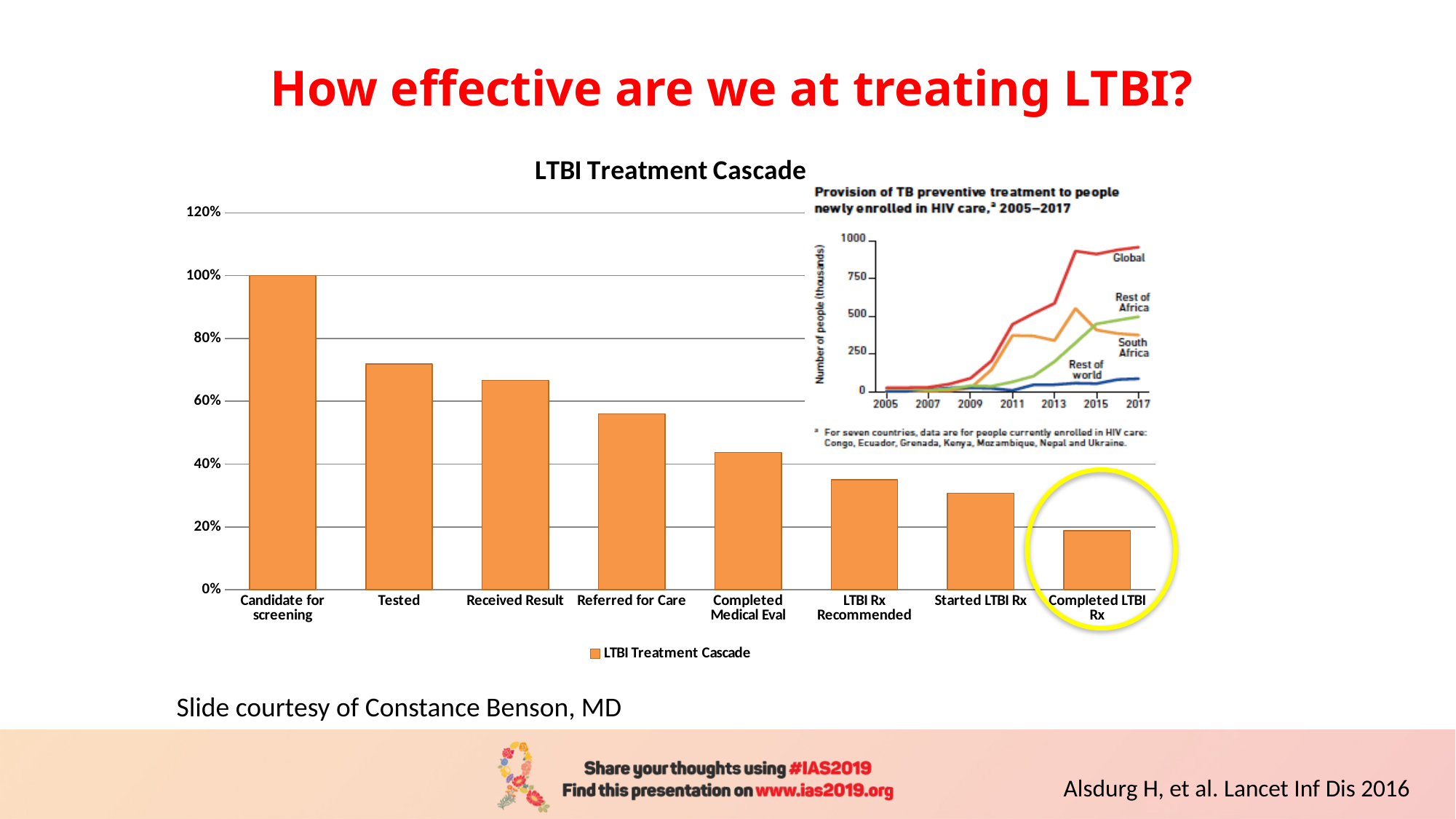
In the LTBI Treatment Cascade bar chart, what is the value for Candidate for screening? 100% In the LTBI Treatment Cascade bar chart, which is larger: Referred for Care or LTBI Rx Recommended? Referred for Care How many categories are shown in the LTBI Treatment Cascade bar chart? 8 In the LTBI Treatment Cascade bar chart, is the value for Completed Medical Eval greater or less than 40%? greater In the LTBI Treatment Cascade bar chart, do the values rise or fall from left to right along the x axis? Fall In the LTBI Treatment Cascade bar chart, which category has the lowest value? Completed LTBI Rx In the LTBI Treatment Cascade bar chart, is the value for Tested greater or less than 60%? greater In the LTBI Treatment Cascade bar chart, which category has the highest value? Candidate for screening What kind of chart is the LTBI Treatment Cascade chart? Bar chart How many series does the legend of the LTBI Treatment Cascade chart list? 1 In the inset chart on the right (Provision of TB preventive treatment to people newly enrolled in HIV care, 2005–2017), which line has the highest value in 2017? Global